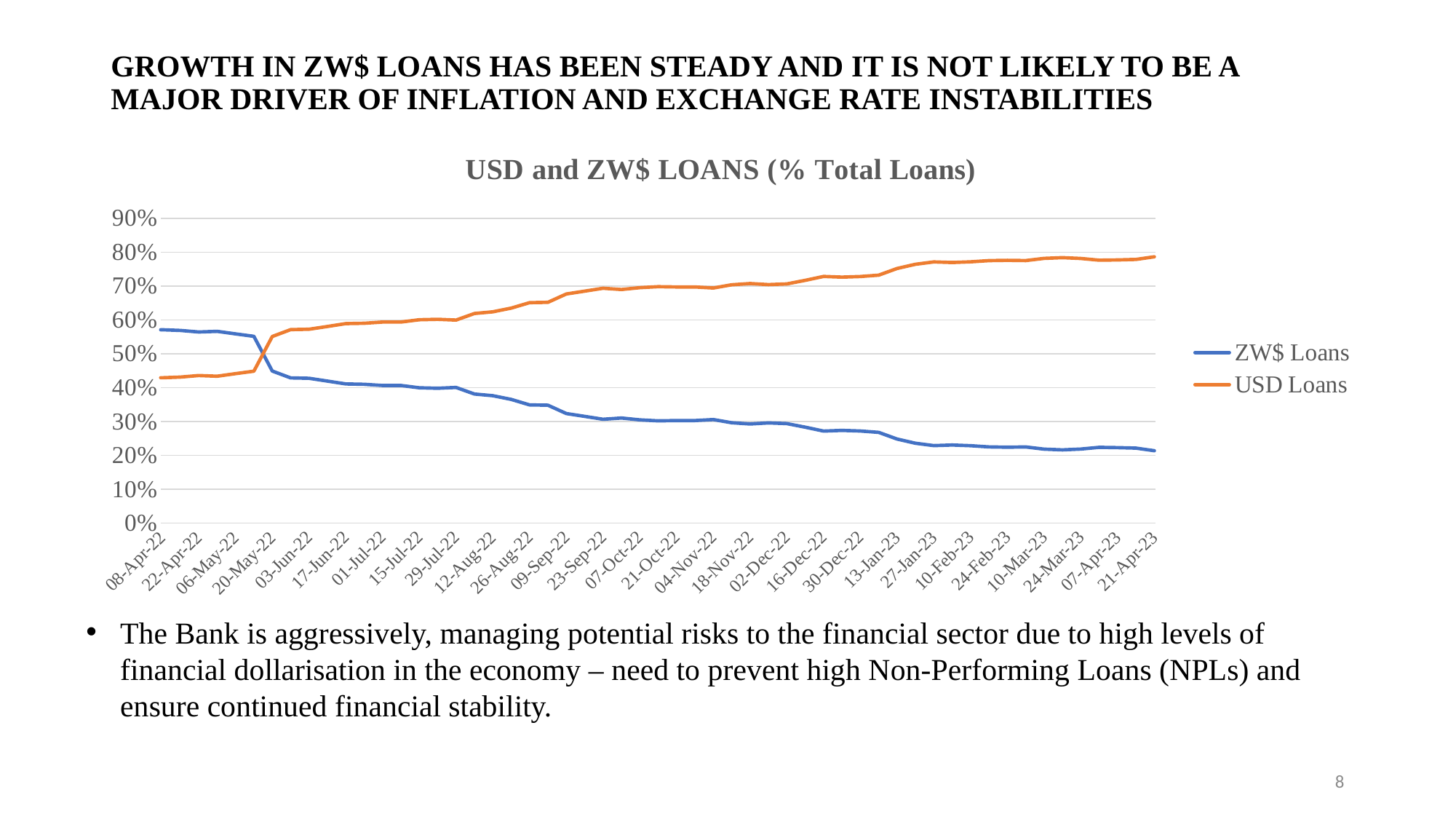
What kind of chart is shown on the slide? Line chart How many series does the legend list? 2 What is the title of the chart? USD and ZW$ LOANS (% Total Loans) Which series is drawn in orange? USD Loans At 21-Apr-23, which series has the higher value, ZW$ Loans or USD Loans? USD Loans Is the value for USD Loans at 21-Apr-23 greater or less than 70%? greater At 08-Apr-22, which series has the higher value, ZW$ Loans or USD Loans? ZW$ Loans Is the value for ZW$ Loans at 21-Apr-23 greater or less than 30%? less Is the value for USD Loans at 08-Apr-22 greater or less than 50%? less Do the values for ZW$ Loans rise or fall from 08-Apr-22 to 21-Apr-23? Fall Do the values for USD Loans rise or fall from 08-Apr-22 to 21-Apr-23? Rise